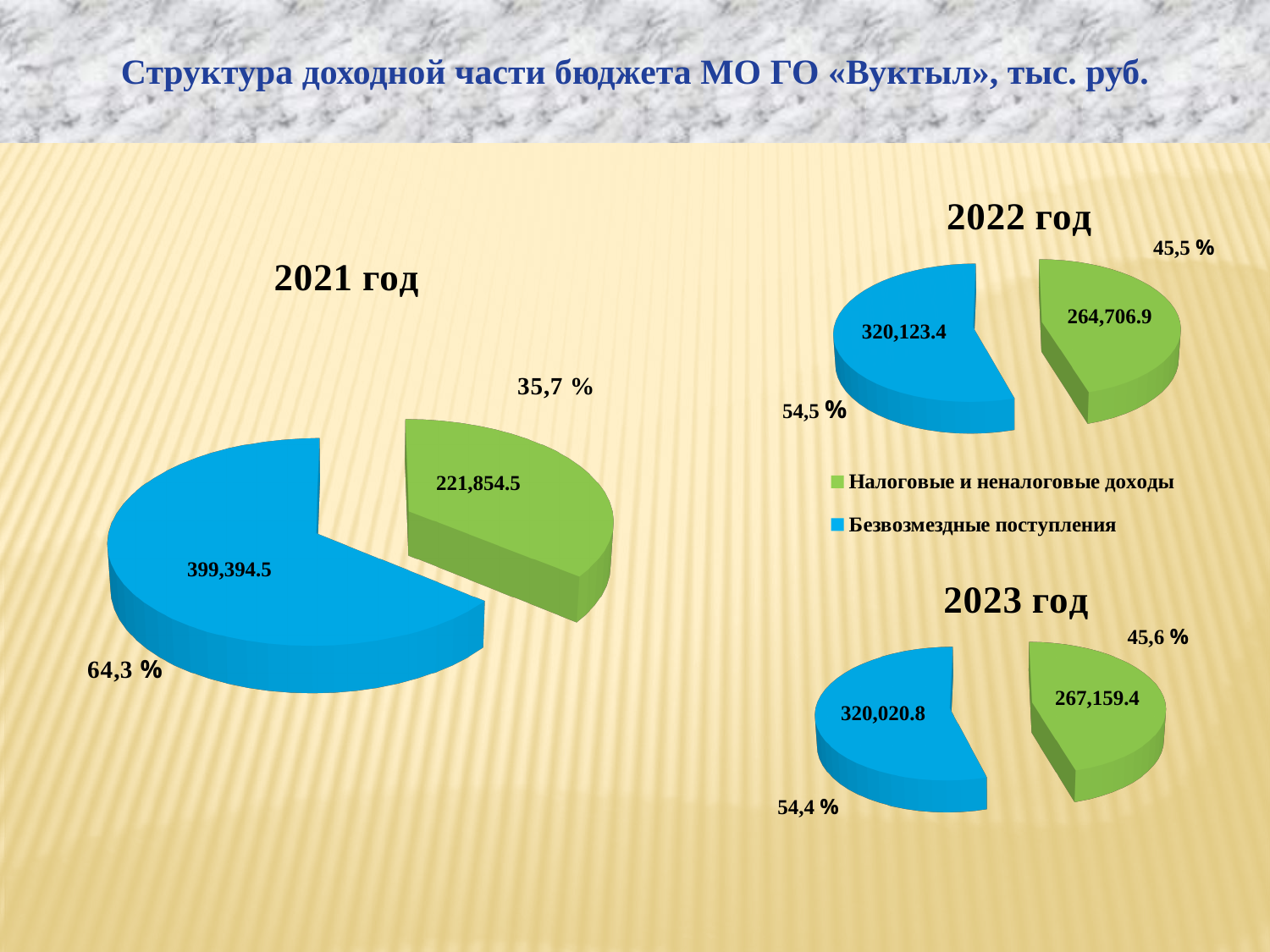
In the 2021 год pie chart, what share of the pie is Безвозмездные поступления? 64,3 % In the 2021 год pie chart, which category is the largest? Безвозмездные поступления In the 2022 год pie chart, what share of the pie is Налоговые и неналоговые доходы? 45,5 % In the 2023 год pie chart, what share of the pie is Безвозмездные поступления? 54,4 % In the 2022 год pie chart, what is the value for Безвозмездные поступления? 320,123.4 In the 2022 год pie chart, what is the difference between Безвозмездные поступления and Налоговые и неналоговые доходы? 55,416.5 In the 2021 год pie chart, what is the value for Налоговые и неналоговые доходы? 221,854.5 In the 2023 год pie chart, what is the value for Налоговые и неналоговые доходы? 267,159.4 In the 2023 год pie chart, which category is the smallest? Налоговые и неналоговые доходы In the 2021 год pie chart, what is the value for Безвозмездные поступления? 399,394.5 What kind of chart is used for 2021 год? Pie chart How many entries does the legend list? 2